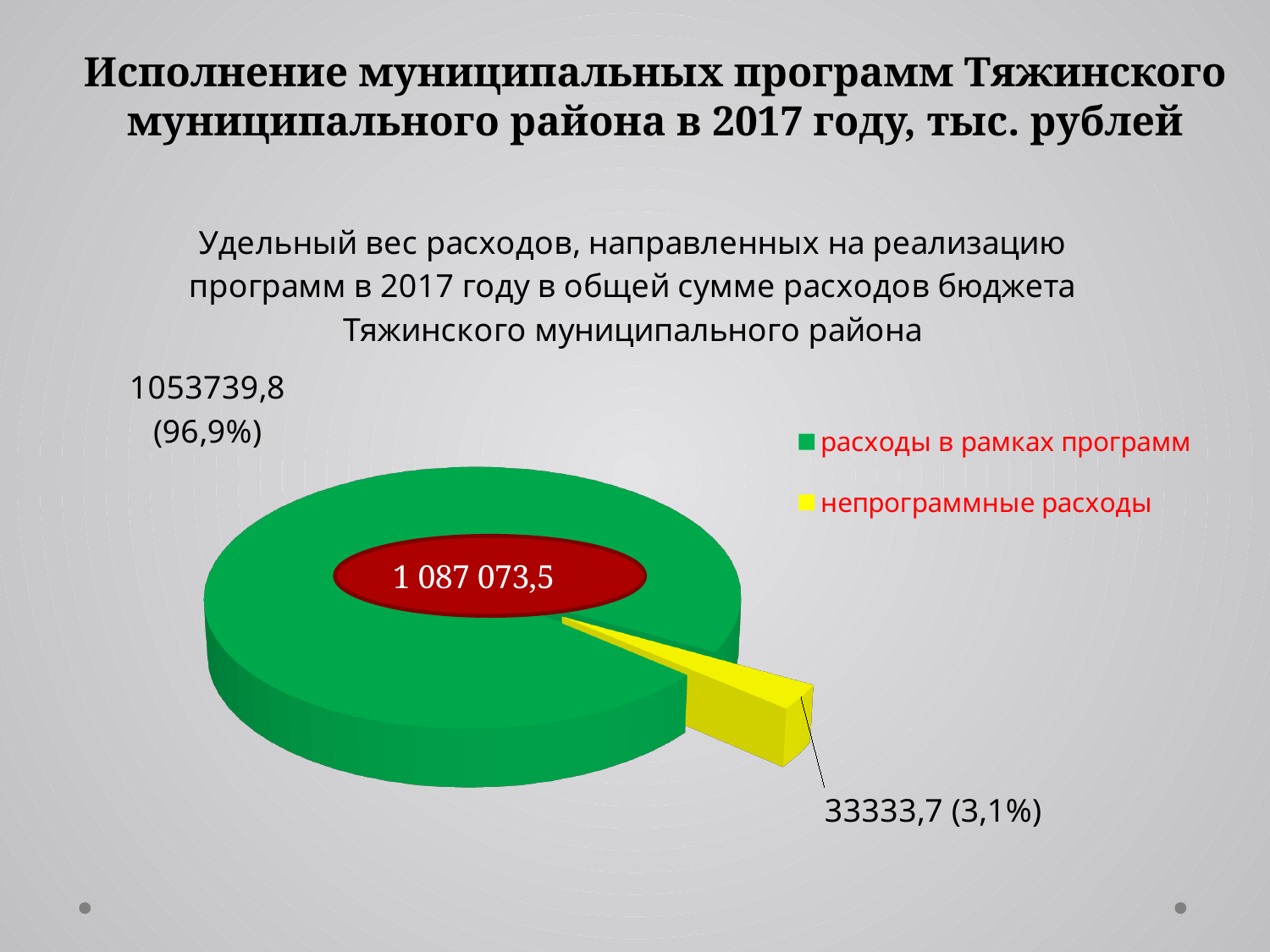
What share of the pie does "расходы в рамках программ" represent? 96,9% What is the value for "расходы в рамках программ"? 1053739,8 What colour is the slice for "непрограммные расходы"? Yellow How many slices does the pie chart have? 2 What total value is printed in the centre of the pie chart? 1 087 073,5 What share of the pie does "непрограммные расходы" represent? 3,1% Which category has the largest slice of the pie? расходы в рамках программ Which is larger: "расходы в рамках программ" or "непрограммные расходы"? расходы в рамках программ Which category has the smallest slice of the pie? непрограммные расходы What is the value for "непрограммные расходы"? 33333,7 How many entries does the legend list? 2 What kind of chart is shown on the slide? Pie chart